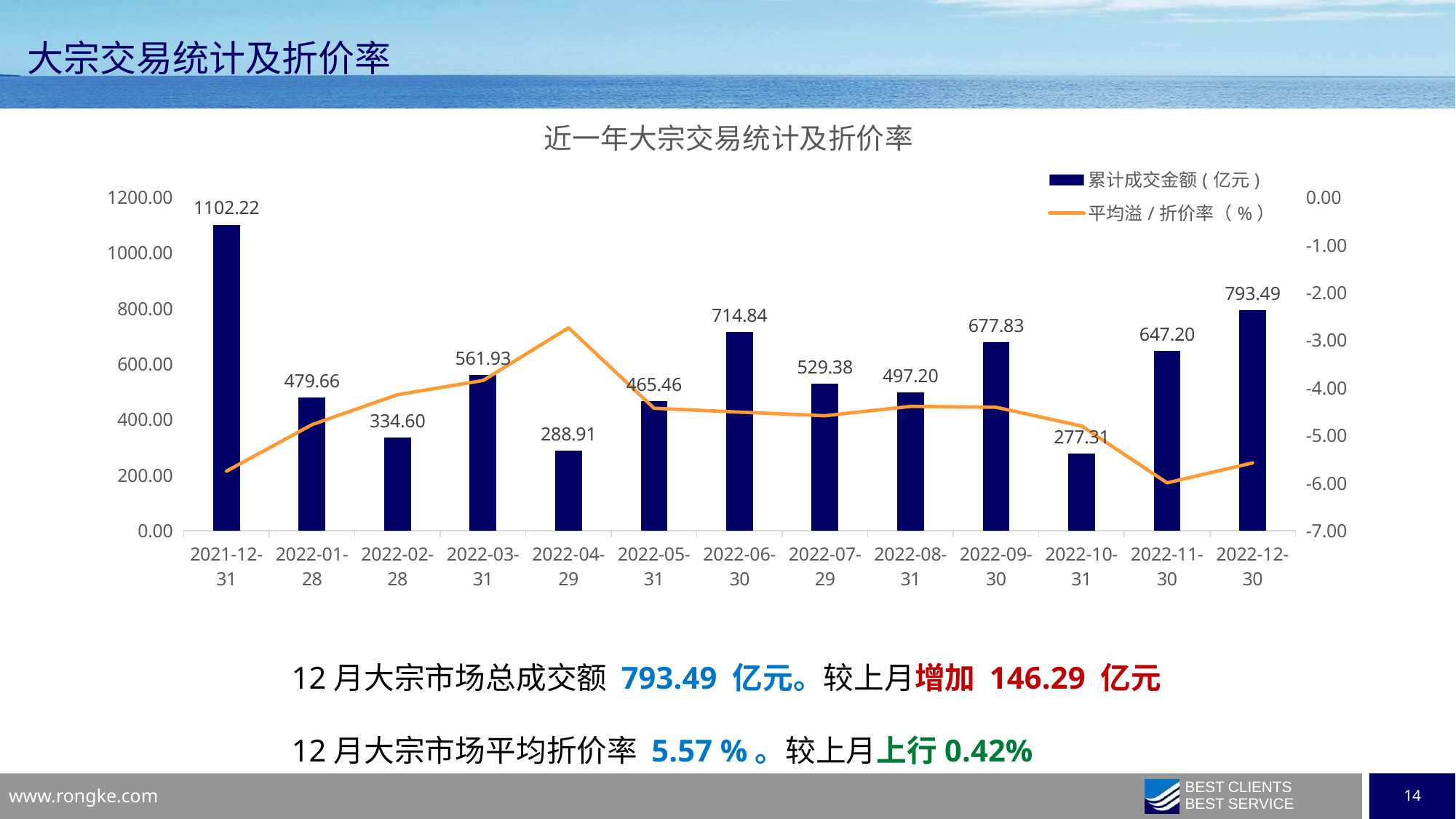
What kind of chart is shown on the slide? Combination bar and line chart How many dates are shown on the x axis of the chart? 13 How many series does the legend list? 2 What is the 累计成交金额 value for 2022-04-29? 288.91 Which is larger, the 累计成交金额 for 2022-09-30 or for 2022-03-31? 2022-09-30 Is the 平均溢/折价率 line value for 2022-04-29 greater or less than -4.00? greater Which date has the lowest 累计成交金额 bar? 2022-10-31 What is the difference between the 累计成交金额 values for 2022-12-30 and 2022-11-30? 146.29 What is the 累计成交金额 value for 2022-12-30? 793.49 What is the 累计成交金额 value for 2022-06-30? 714.84 Do the 累计成交金额 bars rise or fall from 2022-10-31 to 2022-12-30? rise Which date has the highest 累计成交金额 bar? 2021-12-31